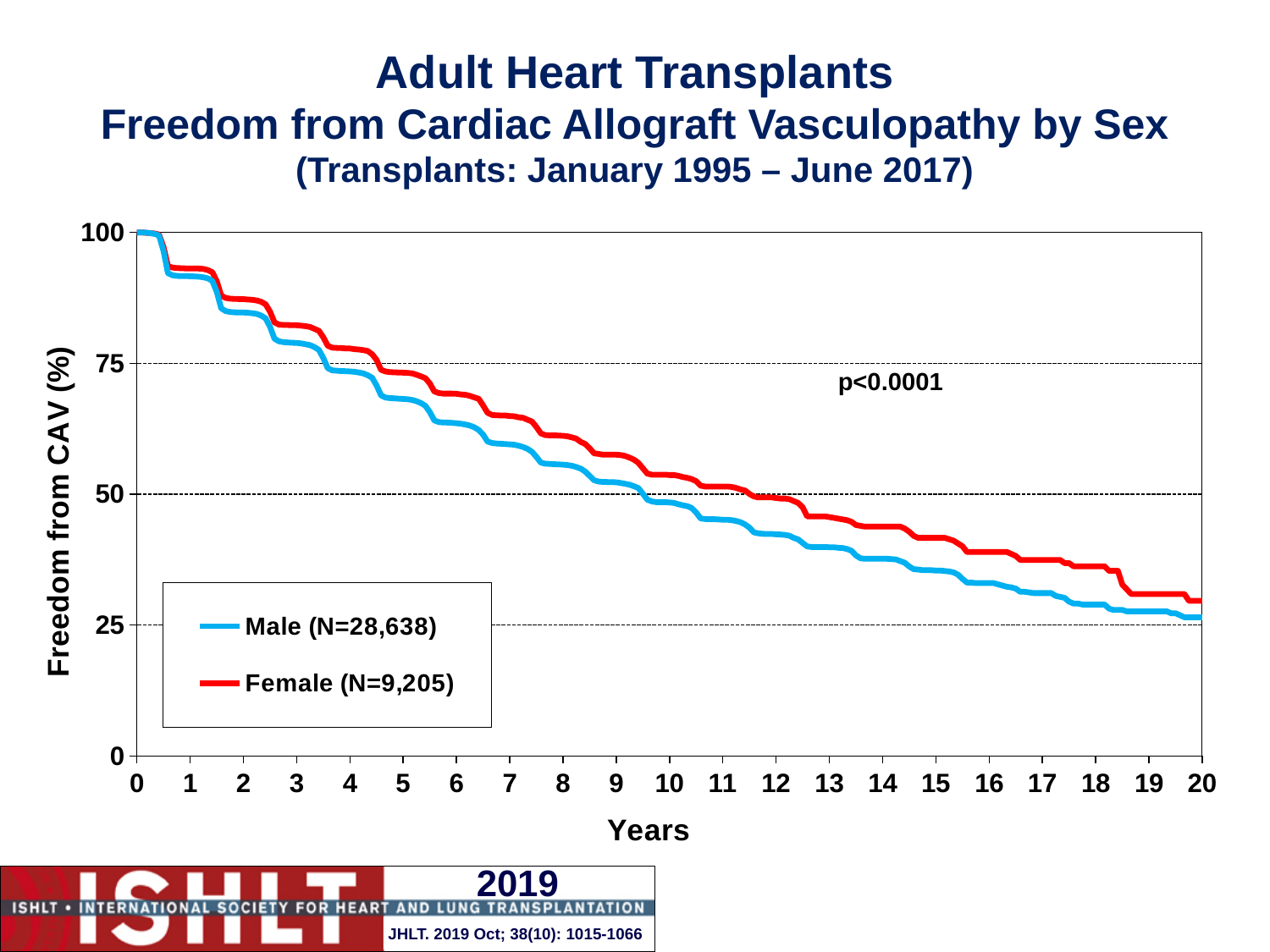
What is the freedom from CAV value for Male at year 0? 100 Do the values for Male rise or fall as the years increase? fall Which series has the higher freedom from CAV at year 10, Male or Female? Female Is the value for Male at year 3 greater or less than 75? greater What kind of chart is shown on the slide? line chart Is the value for Male at year 10 greater or less than 50? less What is the N for the Female series shown in the legend? 9,205 Is the value for Female at year 15 greater or less than 50? less How many series does the legend list? 2 What p-value is printed on the chart? p<0.0001